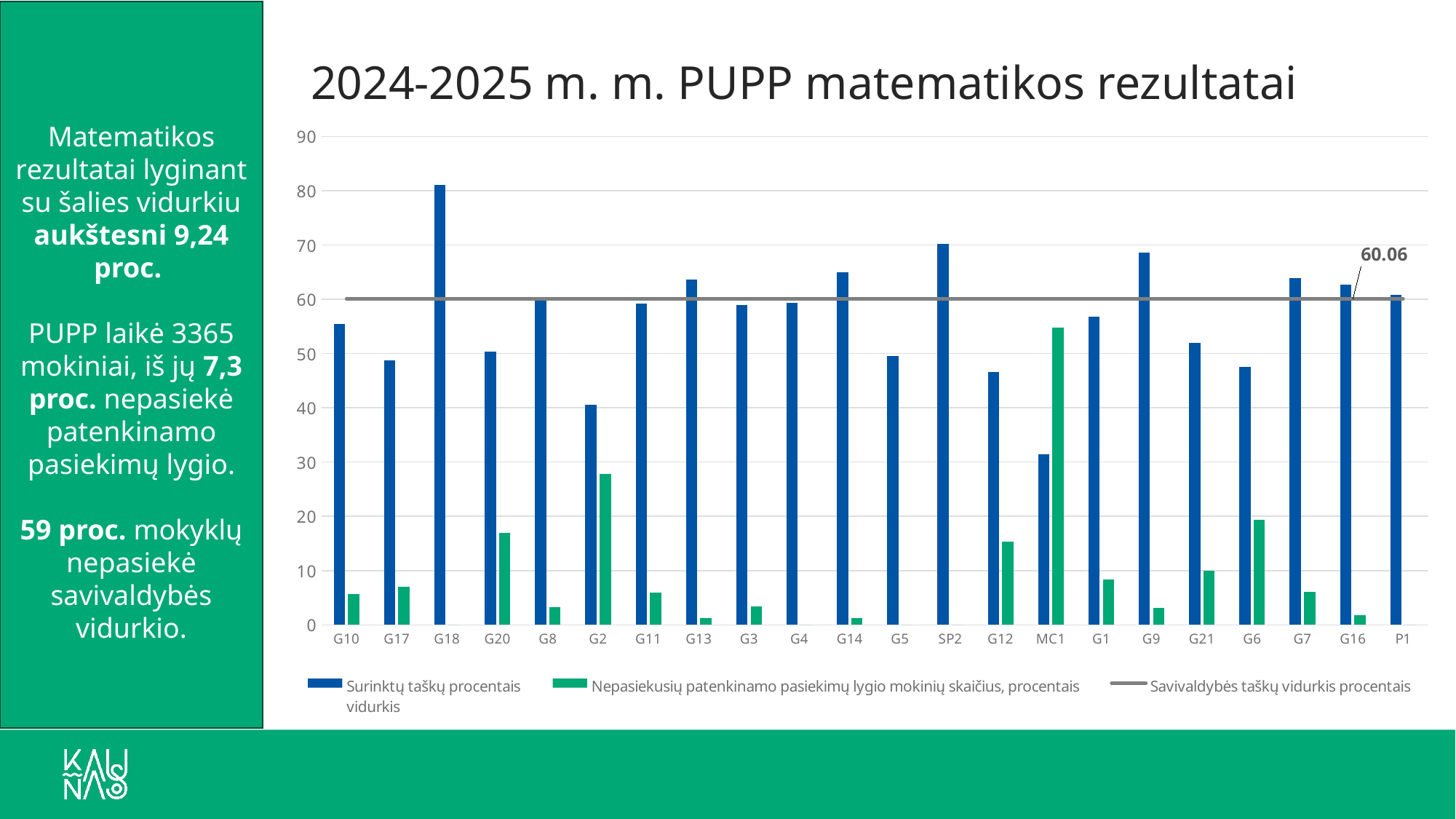
Which category has the highest value for 'Surinktų taškų procentais vidurkis'? G18 What kind of chart is shown on the slide? combination bar and line chart How many categories (schools) are shown on the x axis of the chart? 22 Which category has the lowest value for 'Surinktų taškų procentais vidurkis'? MC1 Which has a larger 'Surinktų taškų procentais vidurkis' value, SP2 or G12? SP2 What value is labelled on the horizontal line for 'Savivaldybės taškų vidurkis procentais'? 60.06 Is the 'Surinktų taškų procentais vidurkis' value for G2 greater or less than 50? less Which category has the highest value for 'Nepasiekusių patenkinamo pasiekimų lygio mokinių skaičius, procentais'? MC1 Is the 'Surinktų taškų procentais vidurkis' value for G18 greater or less than 80? greater How many series does the chart legend list? 3 What is the title of the chart? 2024-2025 m. m. PUPP matematikos rezultatai Is the 'Nepasiekusių patenkinamo pasiekimų lygio mokinių skaičius, procentais' value for G6 greater or less than 10? greater